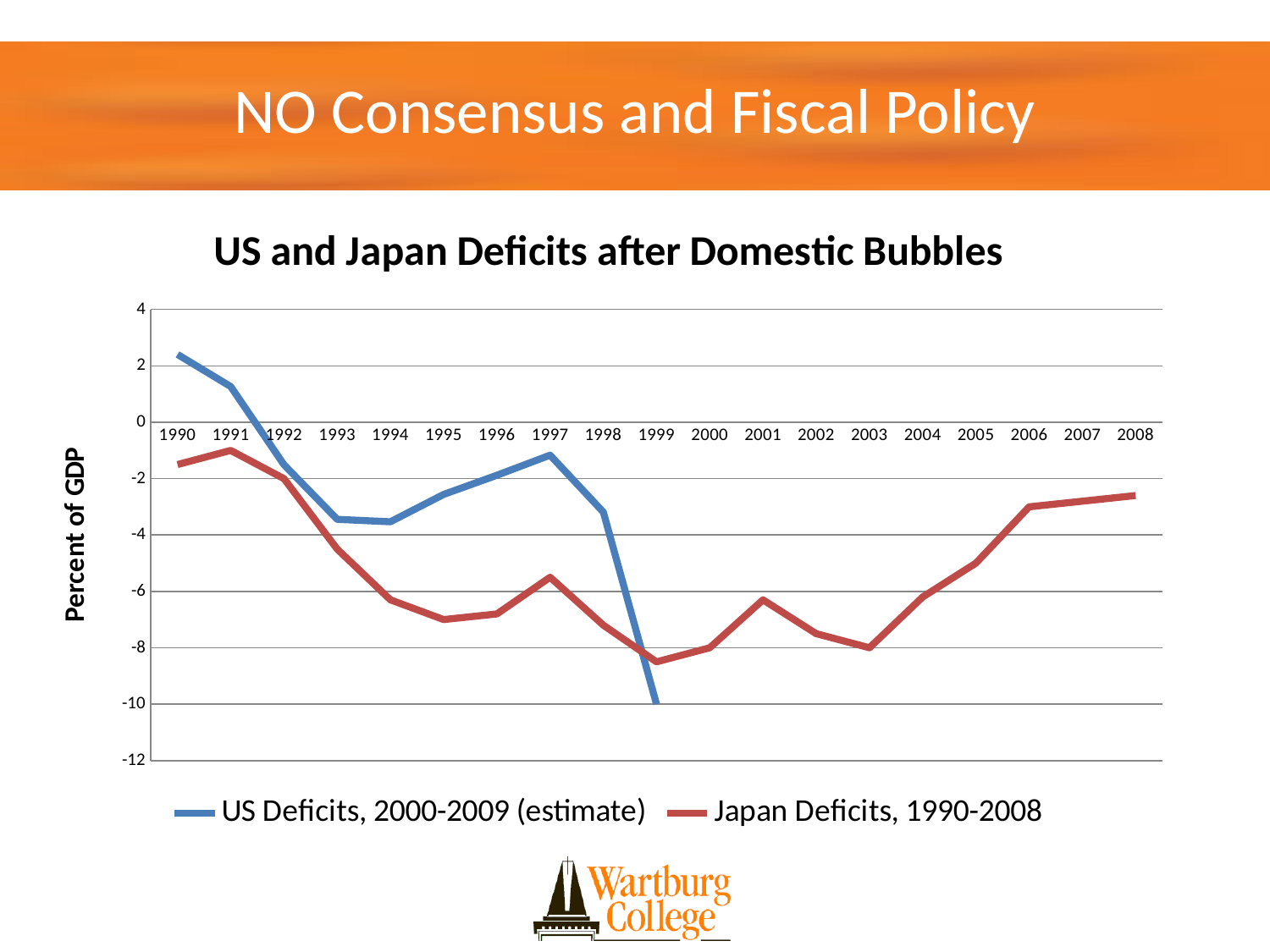
What is the title of the chart? US and Japan Deficits after Domestic Bubbles In which year does the US Deficits series reach its highest value? 1990 In which year does the Japan Deficits series reach its lowest value? 1999 What type of chart is shown on the slide? Line chart How many years are labelled along the x axis? 19 Is the value for Japan Deficits in 1995 greater or less than -6? less How many series does the legend list? 2 Which series has the larger value in 1994, US Deficits or Japan Deficits? US Deficits In which year does the US Deficits series reach its lowest value? 1999 Is the value for US Deficits in 1999 greater or less than -8? less What is the label on the vertical axis? Percent of GDP Does the Japan Deficits series rise or fall between 2003 and 2008? Rise